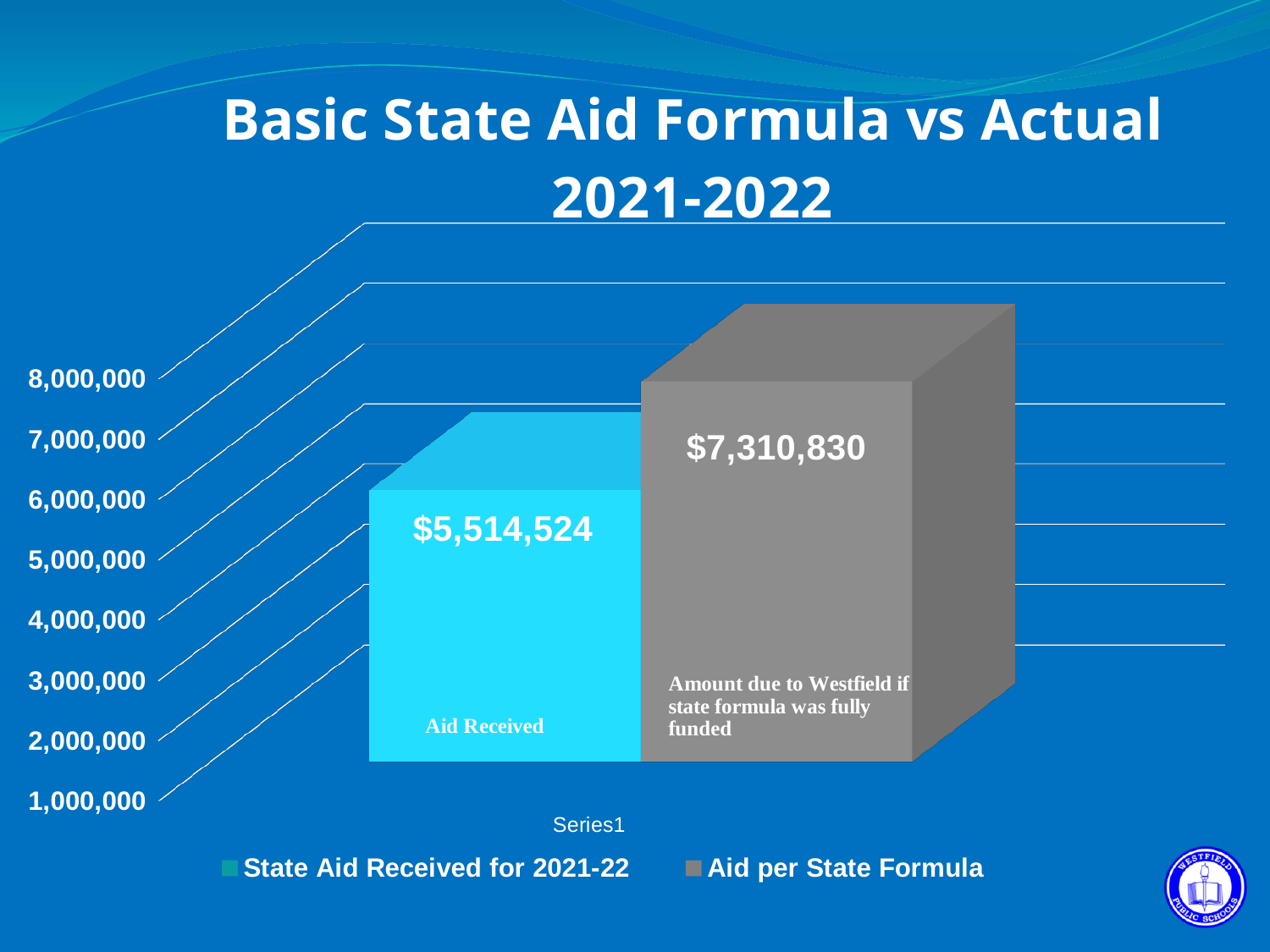
What kind of chart is shown on the slide? Bar chart What is the title of the chart on the slide? Basic State Aid Formula vs Actual 2021-2022 Which series has the highest value on the chart? Aid per State Formula Is the value for Aid per State Formula greater or less than 7,000,000? greater What is the value of the State Aid Received for 2021-22 bar? $5,514,524 What is the difference between the Aid per State Formula value and the State Aid Received for 2021-22 value? $1,796,306 How many bars are plotted on the chart? 2 What is the value of the Aid per State Formula bar? $7,310,830 Which series has the higher value, State Aid Received for 2021-22 or Aid per State Formula? Aid per State Formula Is the value for State Aid Received for 2021-22 greater or less than 6,000,000? less Which series has the lowest value on the chart? State Aid Received for 2021-22 How many series does the legend list? 2